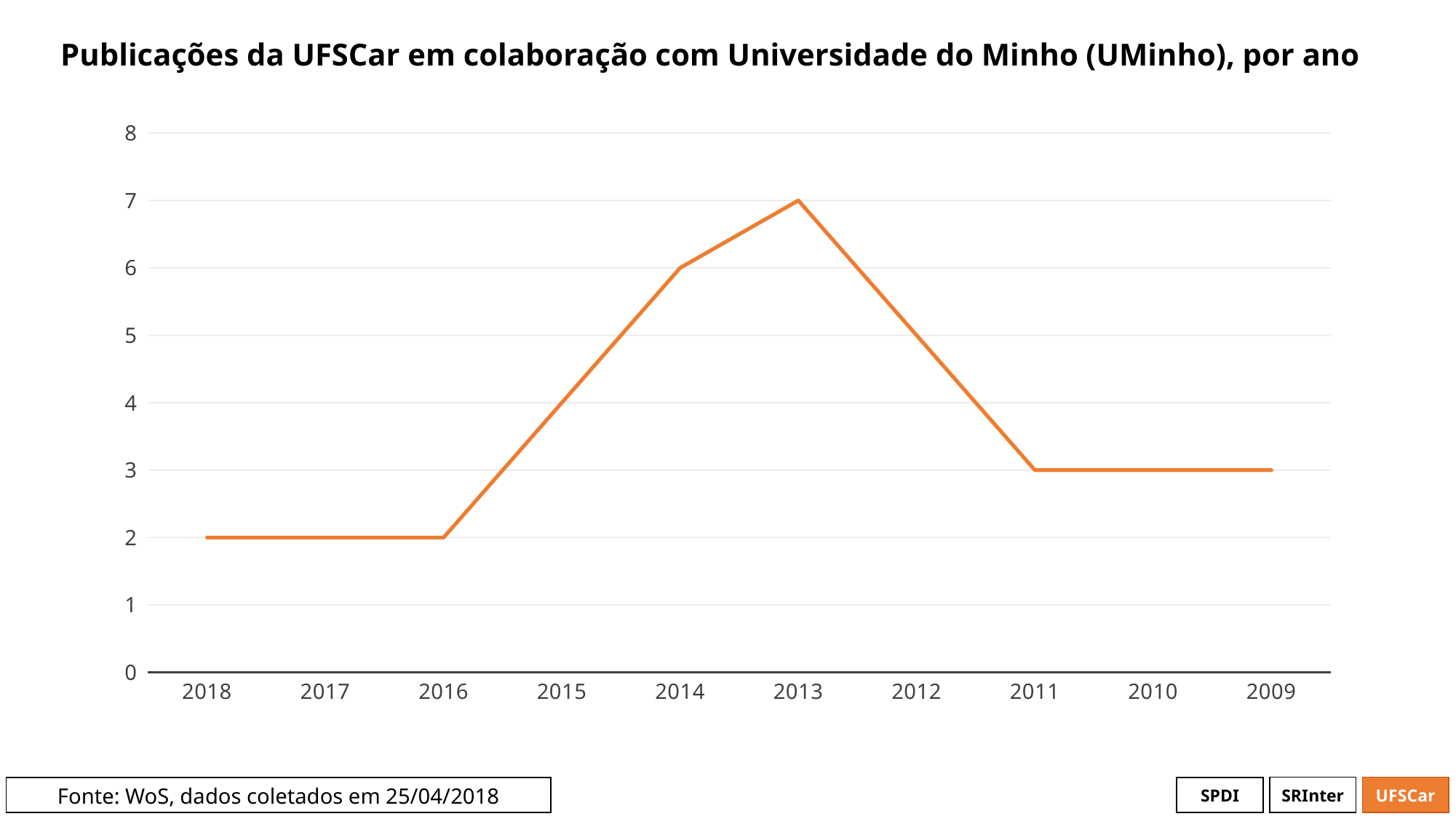
Is the value for 2012 greater or less than 6? less How many years are shown on the x axis of the chart? 10 Which year has the highest number of publications? 2013 What is the difference between the values for 2013 and 2018? 5 What is the number of publications for 2013? 7 What is the number of publications for 2011? 3 What is the number of publications for 2014? 6 What type of chart is shown on the slide? line chart What is the number of publications for 2018? 2 Is the value for 2015 greater or less than 3? greater Moving along the x axis from 2013 to 2011, do the values rise or fall? fall Which year has the larger value, 2014 or 2011? 2014